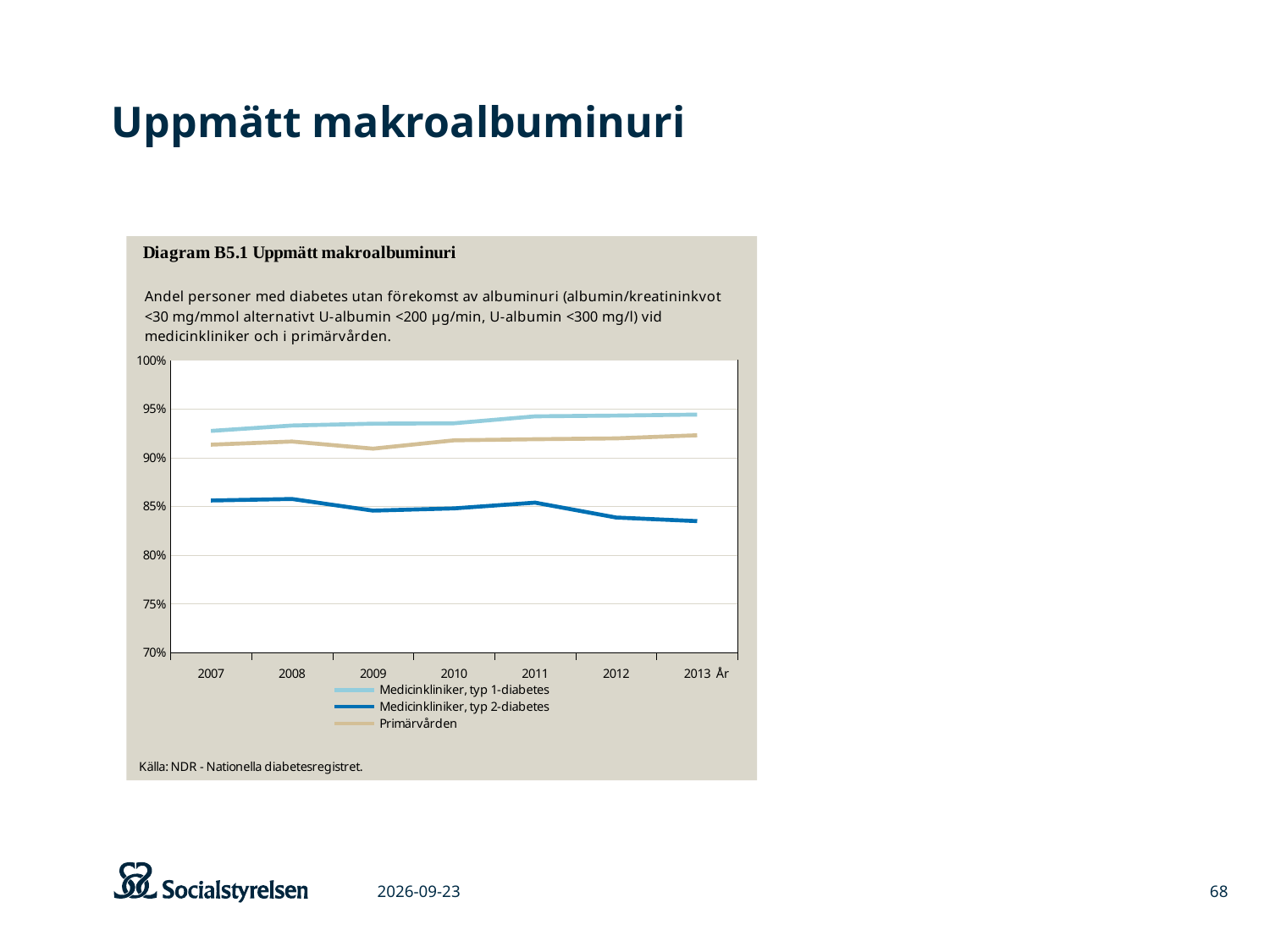
Does the Medicinkliniker, typ 1-diabetes series rise or fall from 2007 to 2013? rise How many years are shown along the x axis? 7 Which series has the highest values across all years? Medicinkliniker, typ 1-diabetes Is the value for Medicinkliniker, typ 1-diabetes in 2007 greater or less than 90%? greater In 2013, which is larger: the value for Primärvården or for Medicinkliniker, typ 2-diabetes? Primärvården Is the value for Primärvården in 2009 greater or less than 95%? less What source is cited below the chart? NDR - Nationella diabetesregistret What kind of chart is shown in Diagram B5.1? line chart How many series does the legend list? 3 Is the value for Medicinkliniker, typ 2-diabetes in 2013 greater or less than 85%? less Which series has the lowest values across all years? Medicinkliniker, typ 2-diabetes Does the Medicinkliniker, typ 2-diabetes series rise or fall from 2011 to 2013? fall